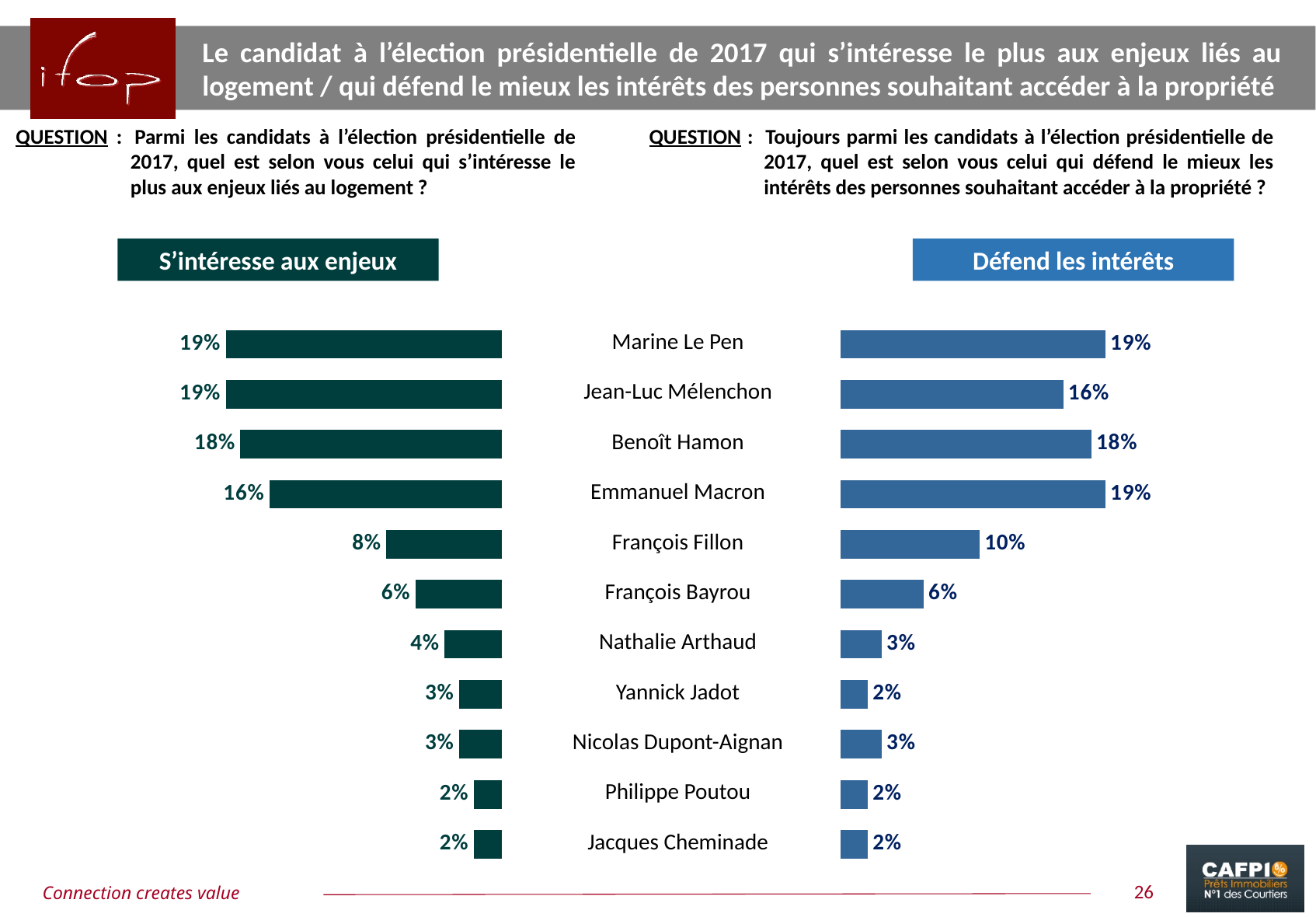
What type of chart is the 'Défend les intérêts' chart? Bar chart In the 'Défend les intérêts' chart, what is the value for Yannick Jadot? 2% In the 'Défend les intérêts' chart, what is the difference between the values for Emmanuel Macron and François Bayrou? 13% How many candidates are listed in the 'S'intéresse aux enjeux' chart? 11 Is Emmanuel Macron's value higher in the 'S'intéresse aux enjeux' chart or in the 'Défend les intérêts' chart? Défend les intérêts In the 'Défend les intérêts' chart, what is the value for François Fillon? 10% In the 'S'intéresse aux enjeux' chart, what is the value for Benoît Hamon? 18% In the 'S'intéresse aux enjeux' chart, what is the difference between the values for Marine Le Pen and François Fillon? 11% In the 'S'intéresse aux enjeux' chart, what is the value for Nathalie Arthaud? 4% In the 'S'intéresse aux enjeux' chart, what is the value for Emmanuel Macron? 16% In the 'S'intéresse aux enjeux' chart, which is larger: the value for François Fillon or the value for François Bayrou? François Fillon In the 'Défend les intérêts' chart, what is the value for Jean-Luc Mélenchon? 16%